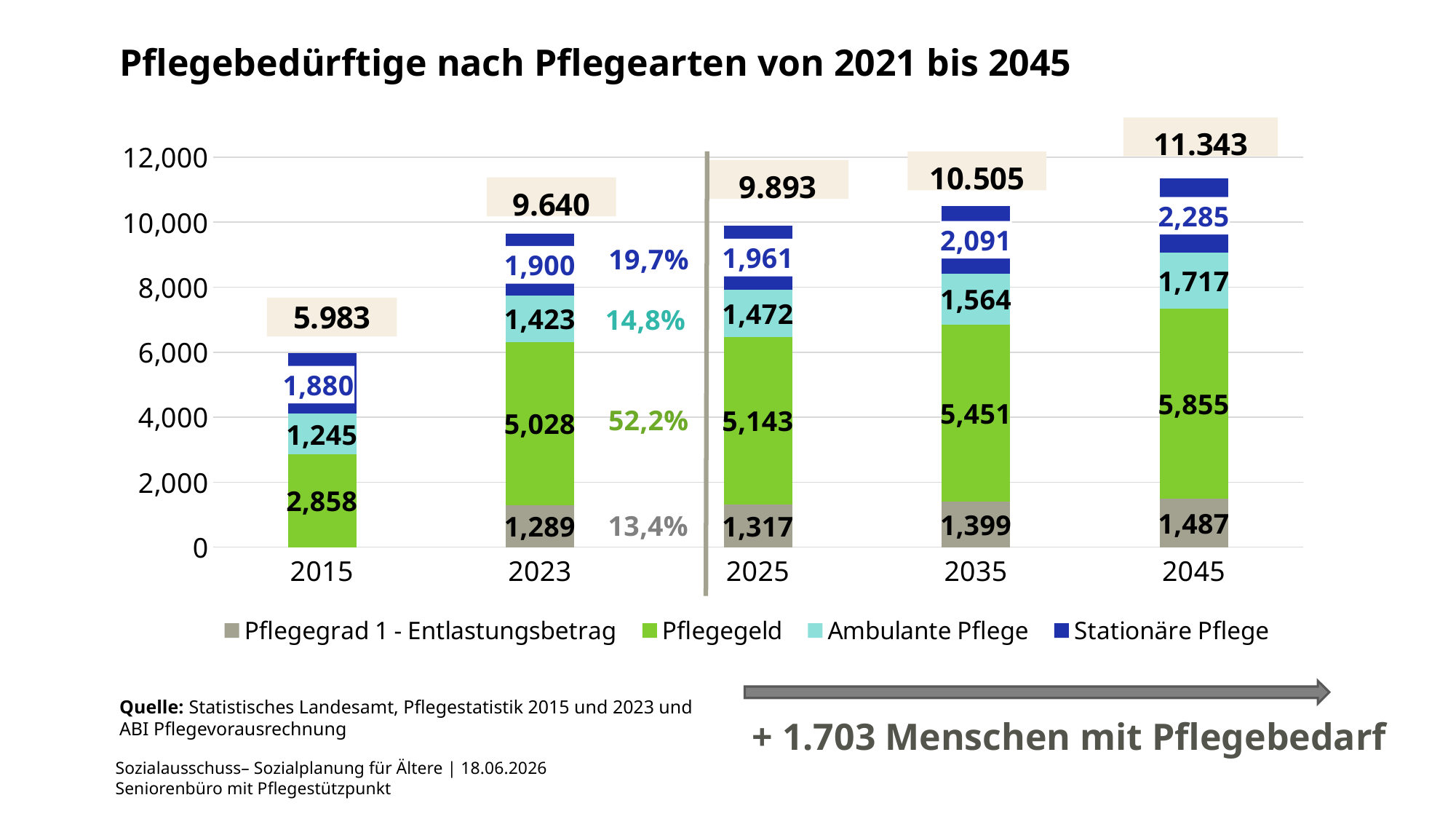
How many series does the legend list? 4 What percentage share is printed next to the Pflegegeld segment of the 2023 bar? 52,2% Is the value for Pflegegeld in 2023 larger or smaller than the value for Pflegegeld in 2015? larger What is the total printed above the bar for 2025? 9.893 What is the difference between the Pflegegeld values for 2035 and 2025? 308 What is the value for Ambulante Pflege in 2015? 1,245 Which year has the lowest total of Pflegebedürftige? 2015 Which year has the highest total of Pflegebedürftige? 2045 How many years are shown on the x axis? 5 What type of chart is shown on the slide? stacked bar chart What is the value for Stationäre Pflege in 2035? 2,091 What is the value for Pflegegeld in 2045? 5,855